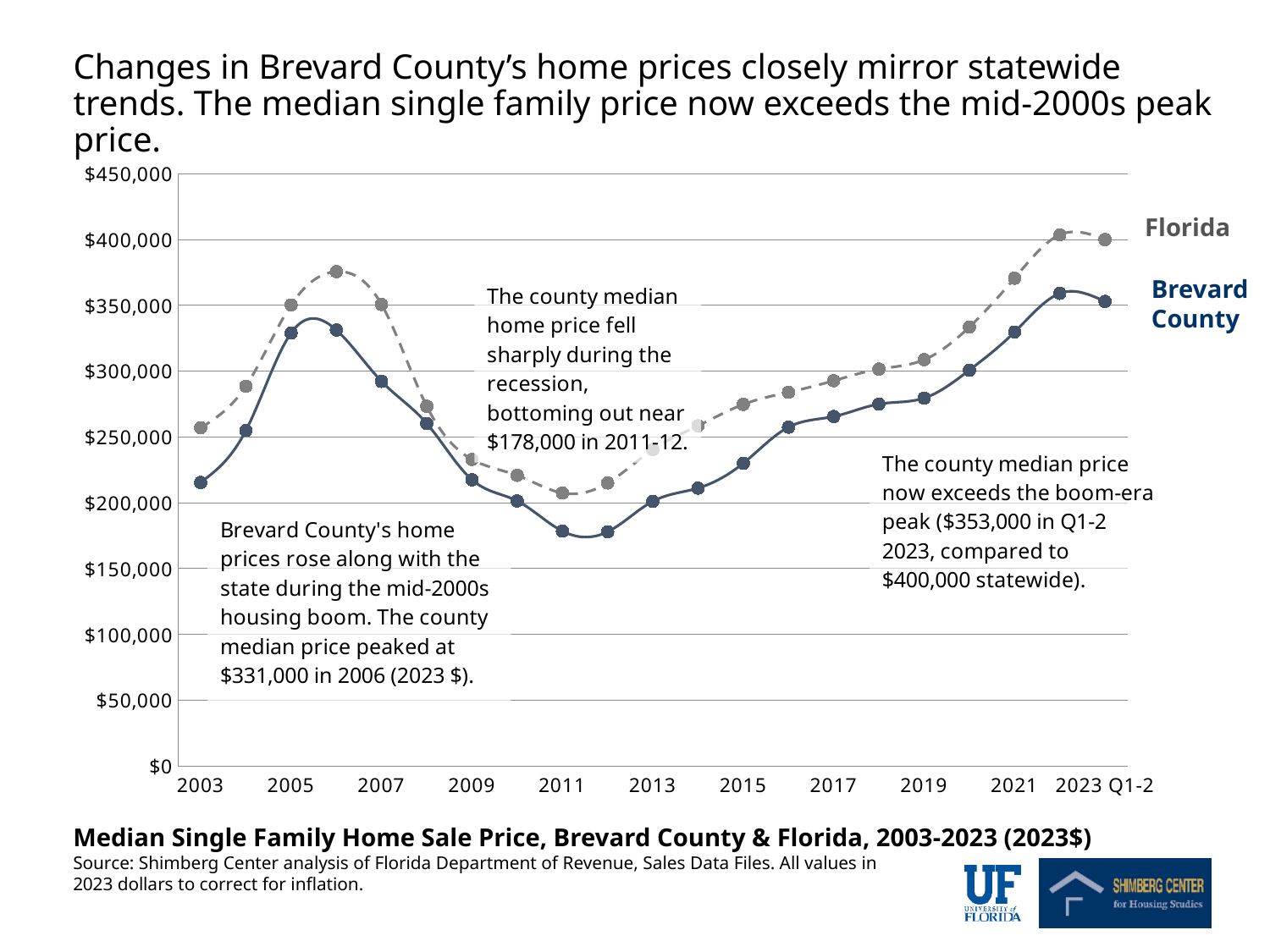
What is the Florida statewide median price in 2023 Q1-2? $400,000 What is the Brevard County median price in 2023 Q1-2? $353,000 Does the Brevard County median price rise or fall between 2012 and 2022? rise What kind of chart is shown on the slide? line chart Which series is drawn with a dashed line? Florida Is the Brevard County value for 2003 greater or less than $250,000? less In 2023 Q1-2, which series has the higher median price, Florida or Brevard County? Florida How many series are plotted on the chart? 2 Is the Florida value for 2006 greater or less than $350,000? greater How much higher is the Florida median price than the Brevard County median price in 2023 Q1-2? $47,000 For Brevard County, which year has the higher median price, 2005 or 2007? 2005 What was Brevard County's median single family home price at its 2006 peak? $331,000